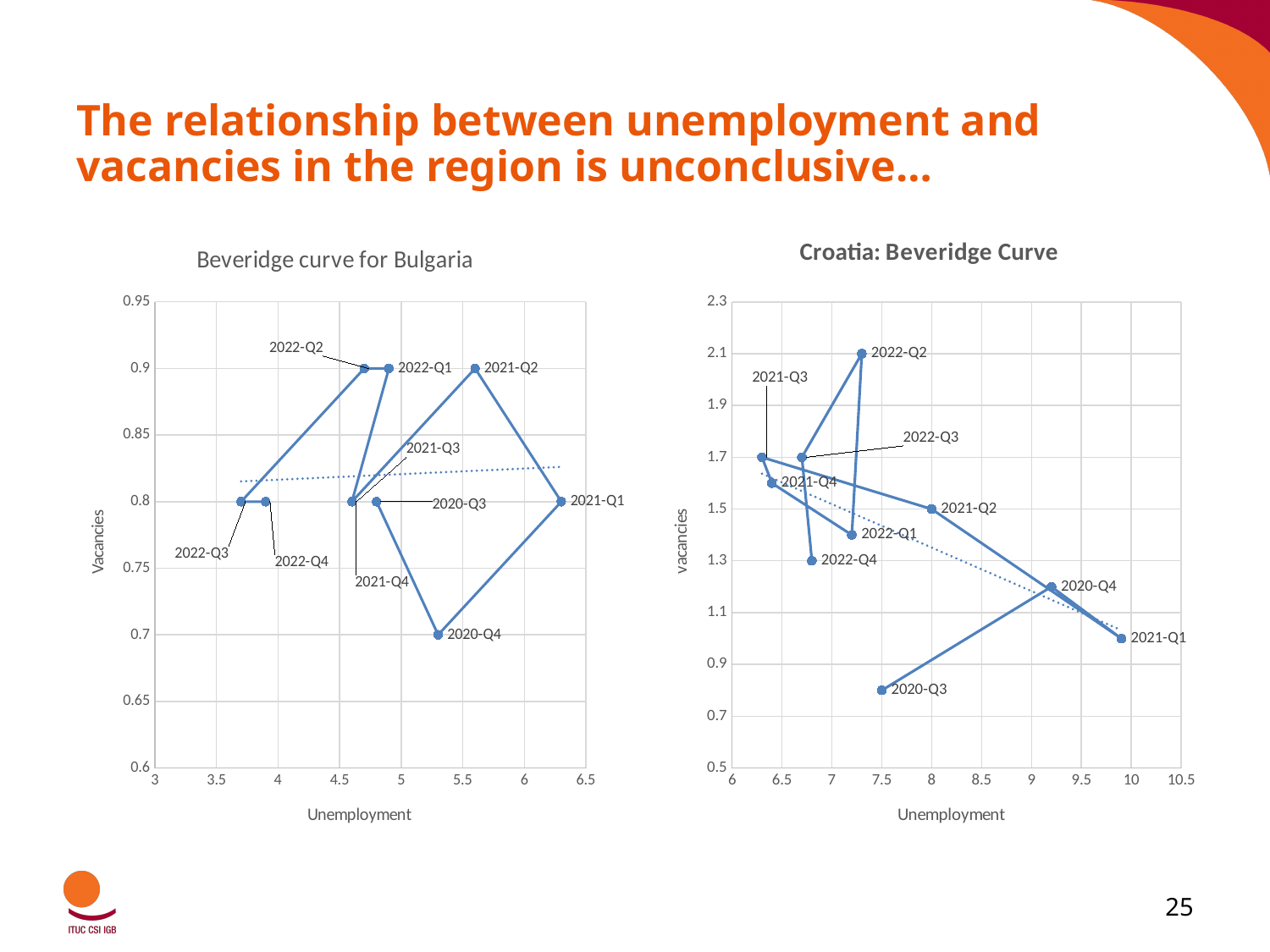
On the Croatia: Beveridge Curve chart, is the unemployment value for 2021-Q1 greater or less than 9.5? greater On the Beveridge curve for Bulgaria chart, is the unemployment value for 2021-Q1 greater or less than 6? greater On the Croatia: Beveridge Curve chart, which quarter has the highest vacancies value? 2022-Q2 On the Croatia: Beveridge Curve chart, is the vacancies value for 2020-Q3 greater or less than 0.9? less On the Beveridge curve for Bulgaria chart, which has the higher vacancies value, 2021-Q2 or 2020-Q4? 2021-Q2 On the Croatia: Beveridge Curve chart, which quarter has the lowest vacancies value? 2020-Q3 On the Beveridge curve for Bulgaria chart, which quarter has the highest unemployment value? 2021-Q1 On the Croatia: Beveridge Curve chart, which quarter has the highest unemployment value? 2021-Q1 On the Beveridge curve for Bulgaria chart, what is the vacancies value for 2020-Q4? 0.7 On the Beveridge curve for Bulgaria chart, which quarter has the lowest vacancies value? 2020-Q4 On the Croatia: Beveridge Curve chart, what is the vacancies value for 2022-Q2? 2.1 What is the label on the horizontal axis of the Croatia: Beveridge Curve chart? Unemployment